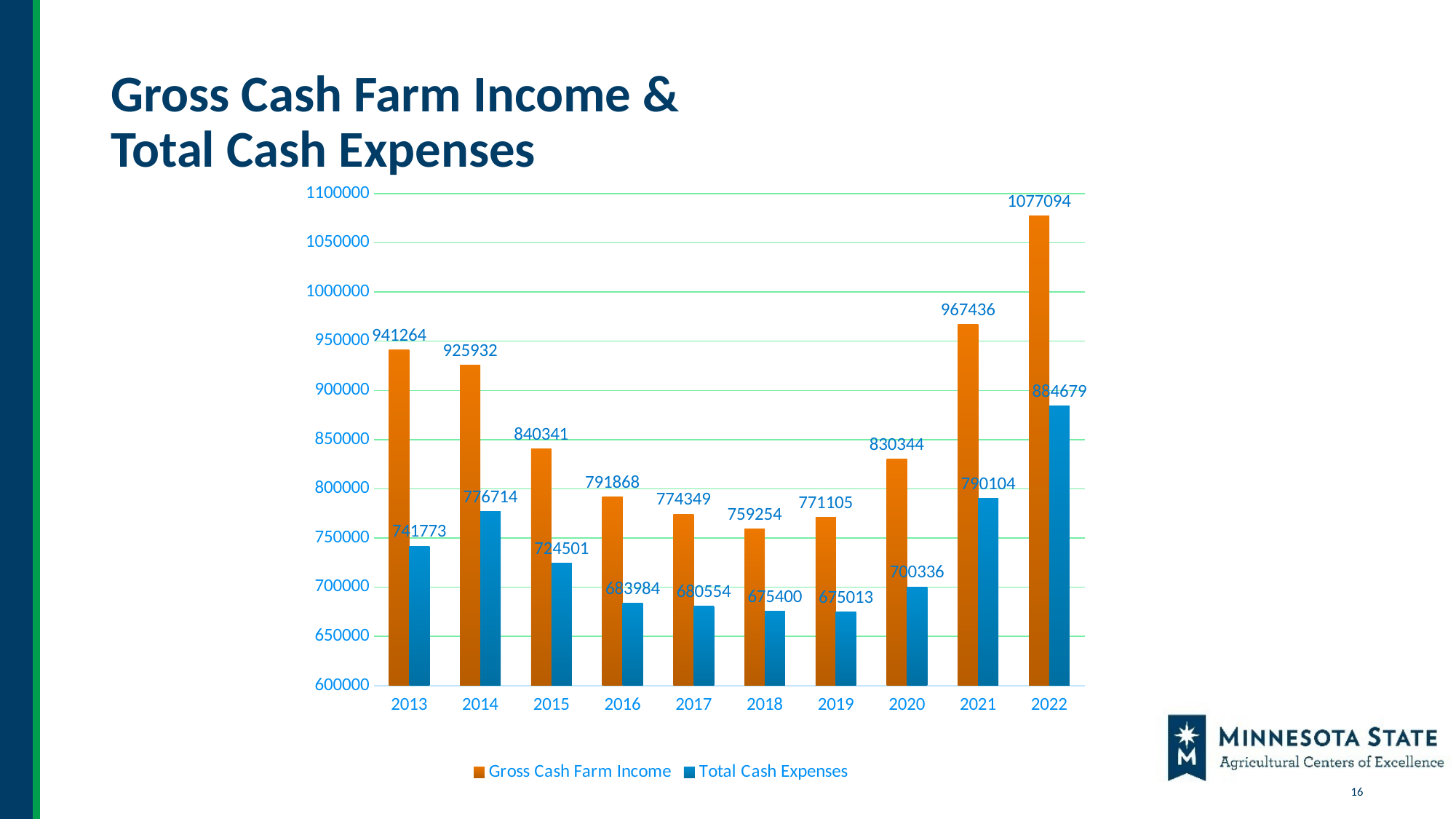
Which is larger: Total Cash Expenses in 2014 or Total Cash Expenses in 2021? 2021 What is the difference between Gross Cash Farm Income and Total Cash Expenses in 2022? 192415 Is the Gross Cash Farm Income for 2020 greater or less than 800000? greater How many years are shown on the x axis? 10 What type of chart is shown on the slide? Bar chart Which year has the highest Gross Cash Farm Income? 2022 How many series does the legend list? 2 Which year has the lowest Total Cash Expenses? 2019 Which year has the lowest Gross Cash Farm Income? 2018 What is the difference between Gross Cash Farm Income and Total Cash Expenses in 2013? 199491 What is the Total Cash Expenses value for 2016? 683984 What is the Gross Cash Farm Income for 2022? 1077094